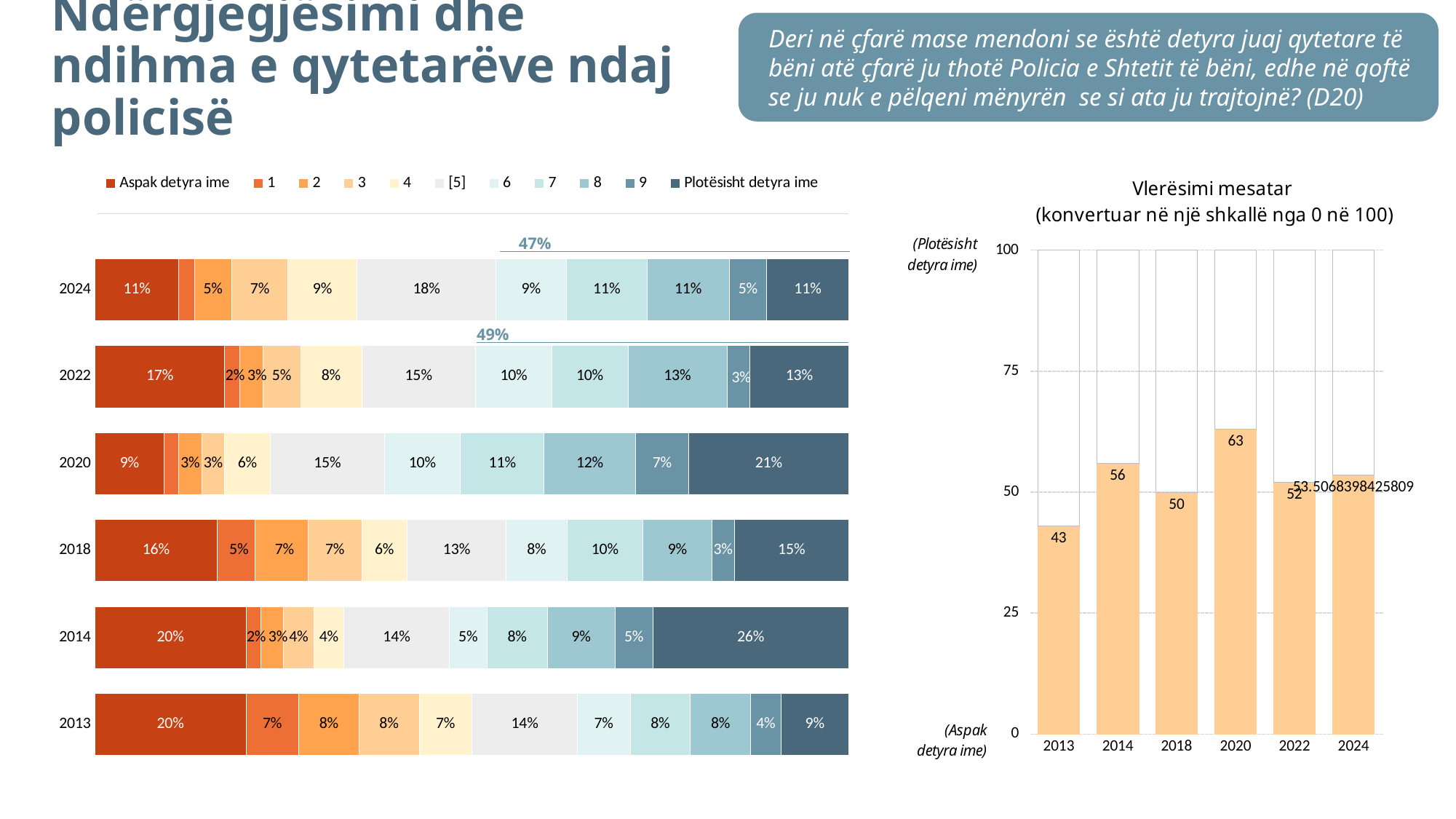
In the chart titled 'Vlerësimi mesatar', what is the value for 2020? 63 In the chart titled 'Vlerësimi mesatar', which year has the lowest value? 2013 In the chart titled 'Vlerësimi mesatar', is the value for 2024 greater or less than 50? greater What kind of chart is the chart titled 'Vlerësimi mesatar'? bar chart In the stacked bar chart on the left, how many series does the legend list? 11 In the chart titled 'Vlerësimi mesatar', which year has the highest value? 2020 In the stacked bar chart on the left, what percentage is shown for 'Plotësisht detyra ime' in 2014? 26% In the stacked bar chart on the left, which is larger: the 'Aspak detyra ime' share in 2013 or in 2024? 2013 In the stacked bar chart on the left, what percentage is shown for 'Aspak detyra ime' in 2022? 17% In the chart titled 'Vlerësimi mesatar', how many years are shown on the x axis? 6 In the chart titled 'Vlerësimi mesatar', what is the difference between the values for 2014 and 2018? 6 In the chart titled 'Vlerësimi mesatar', what is the value for 2013? 43